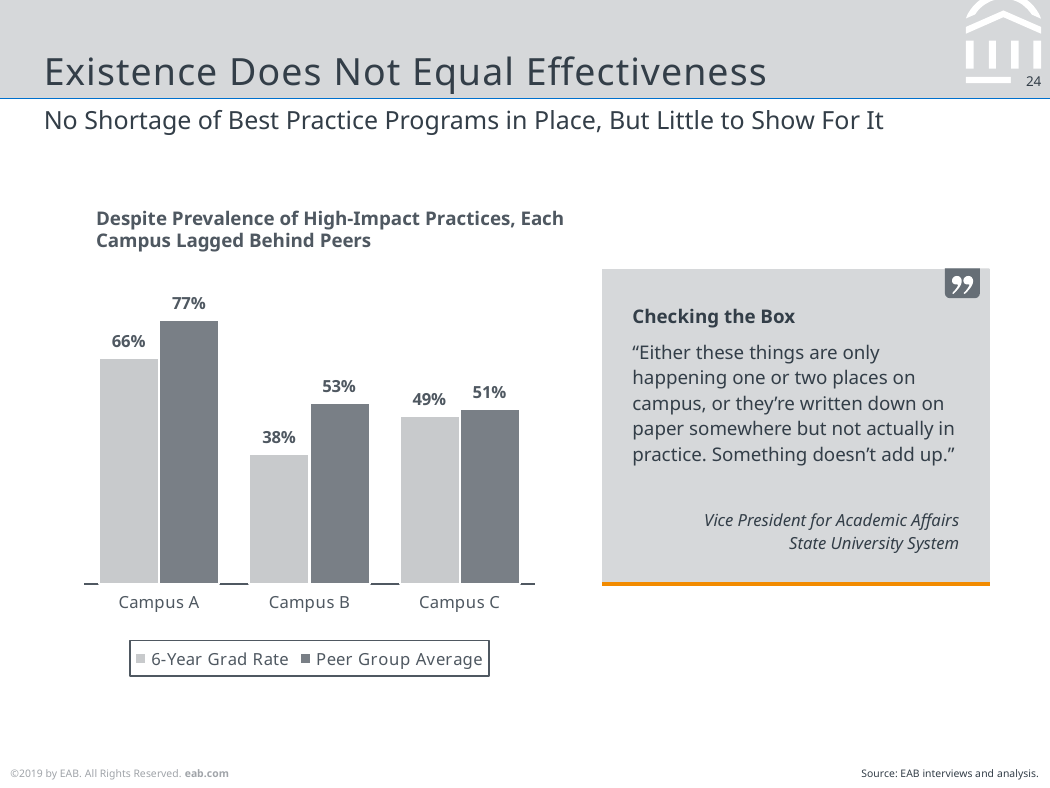
Which campus has the highest Peer Group Average? Campus A What is the title of the chart? Despite Prevalence of High-Impact Practices, Each Campus Lagged Behind Peers What is the difference between the Peer Group Average and the 6-Year Grad Rate for Campus A? 11% How many campuses are shown on the chart? 3 What is the Peer Group Average for Campus B? 53% Which is larger for Campus C, the 6-Year Grad Rate or the Peer Group Average? Peer Group Average Which campus has the lowest 6-Year Grad Rate? Campus B What is the difference between the Peer Group Average and the 6-Year Grad Rate for Campus B? 15% What is the 6-Year Grad Rate for Campus A? 66% How many series does the legend list? 2 What kind of chart is shown on the slide? Bar chart What is the 6-Year Grad Rate for Campus C? 49%